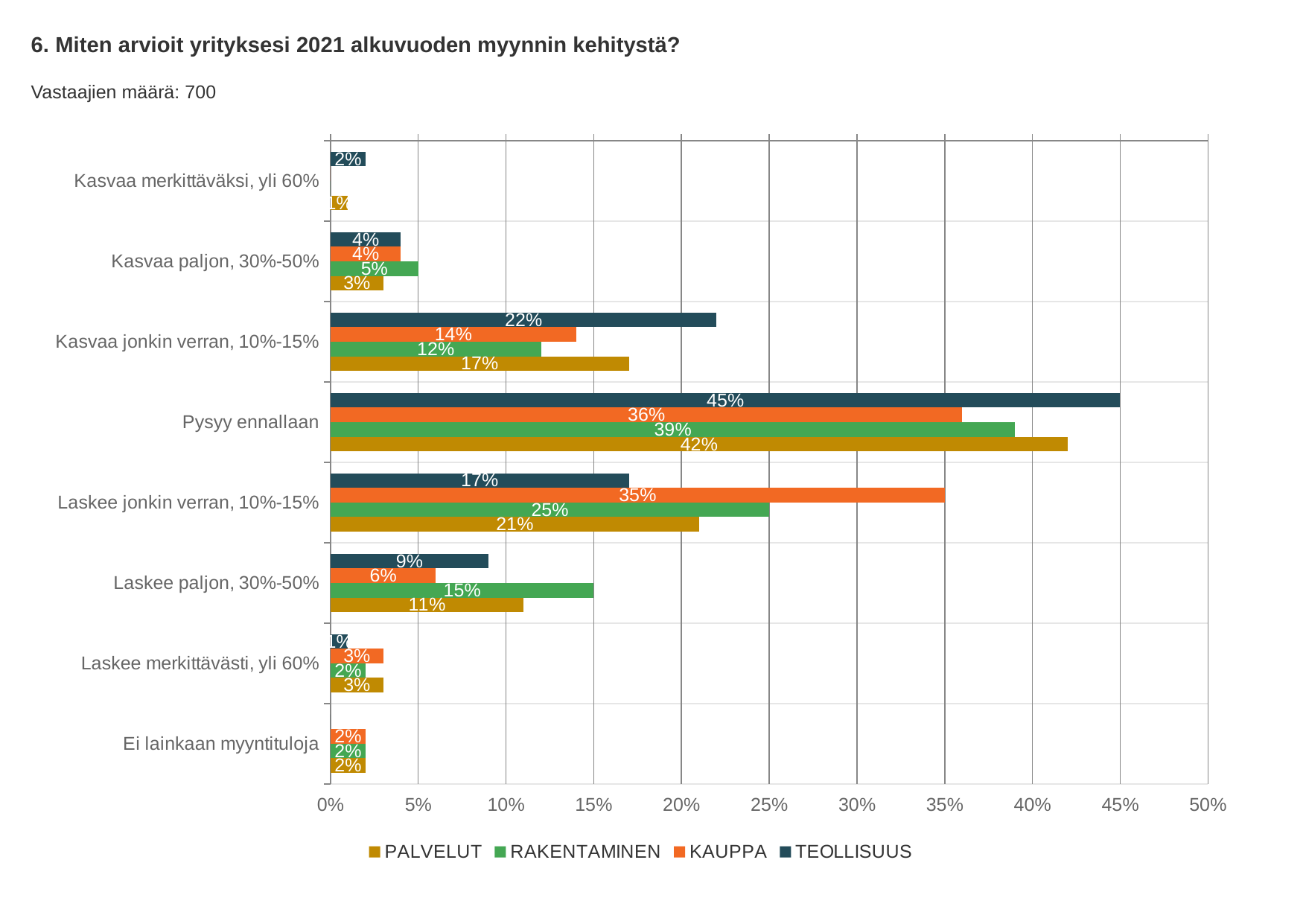
Which series has the lowest value in the category "Laskee paljon, 30%-50%"? KAUPPA Which series has the highest value in the category "Pysyy ennallaan"? TEOLLISUUS What is the value for KAUPPA in the category "Laskee jonkin verran, 10%-15%"? 35% How many series does the legend list? 4 What is the difference between the KAUPPA and TEOLLISUUS values in the category "Laskee jonkin verran, 10%-15%"? 18% How many respondents (Vastaajien määrä) are stated on the slide? 700 What kind of chart is shown on the slide? bar chart How many categories are shown on the vertical axis? 8 What is the value for TEOLLISUUS in the category "Pysyy ennallaan"? 45% What is the value for PALVELUT in the category "Kasvaa jonkin verran, 10%-15%"? 17% In the category "Kasvaa jonkin verran, 10%-15%", which is larger: the value for TEOLLISUUS or the value for KAUPPA? TEOLLISUUS What is the value for RAKENTAMINEN in the category "Laskee paljon, 30%-50%"? 15%